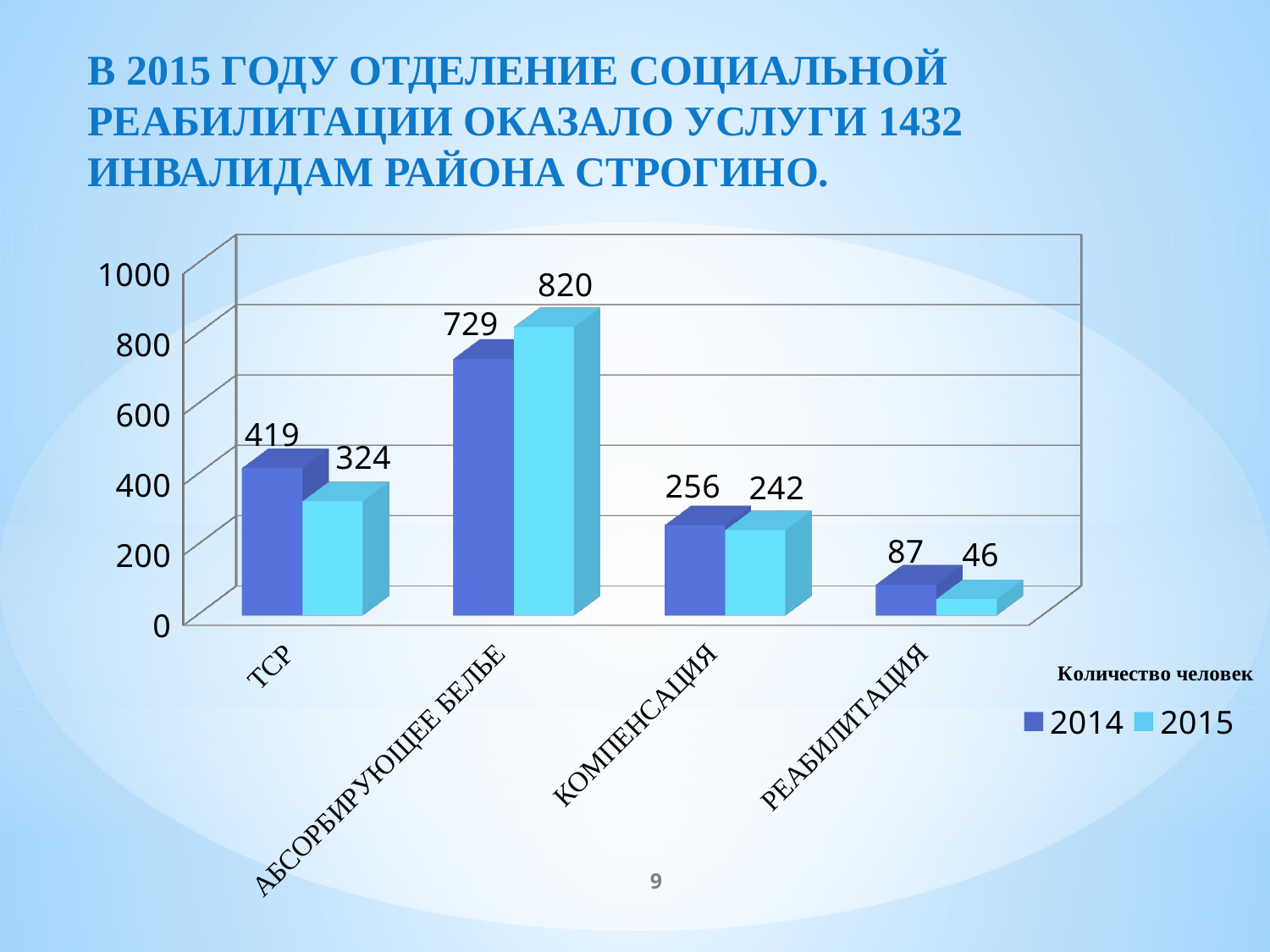
What is the value for ТСР in 2014? 419 How many categories are shown on the x axis? 4 What are the two series named in the legend? 2014 and 2015 Which category has the highest value in 2015? АБСОРБИРУЮЩЕЕ БЕЛЬЕ What is the value for АБСОРБИРУЮЩЕЕ БЕЛЬЕ in 2015? 820 How many series does the legend list? 2 Which category has the lowest value in 2014? РЕАБИЛИТАЦИЯ Which is larger for АБСОРБИРУЮЩЕЕ БЕЛЬЕ: the 2014 value or the 2015 value? 2015 What is the difference between the 2014 and 2015 values for ТСР? 95 What kind of chart is shown on the slide? bar chart What is the value for РЕАБИЛИТАЦИЯ in 2015? 46 What is the value for КОМПЕНСАЦИЯ in 2014? 256